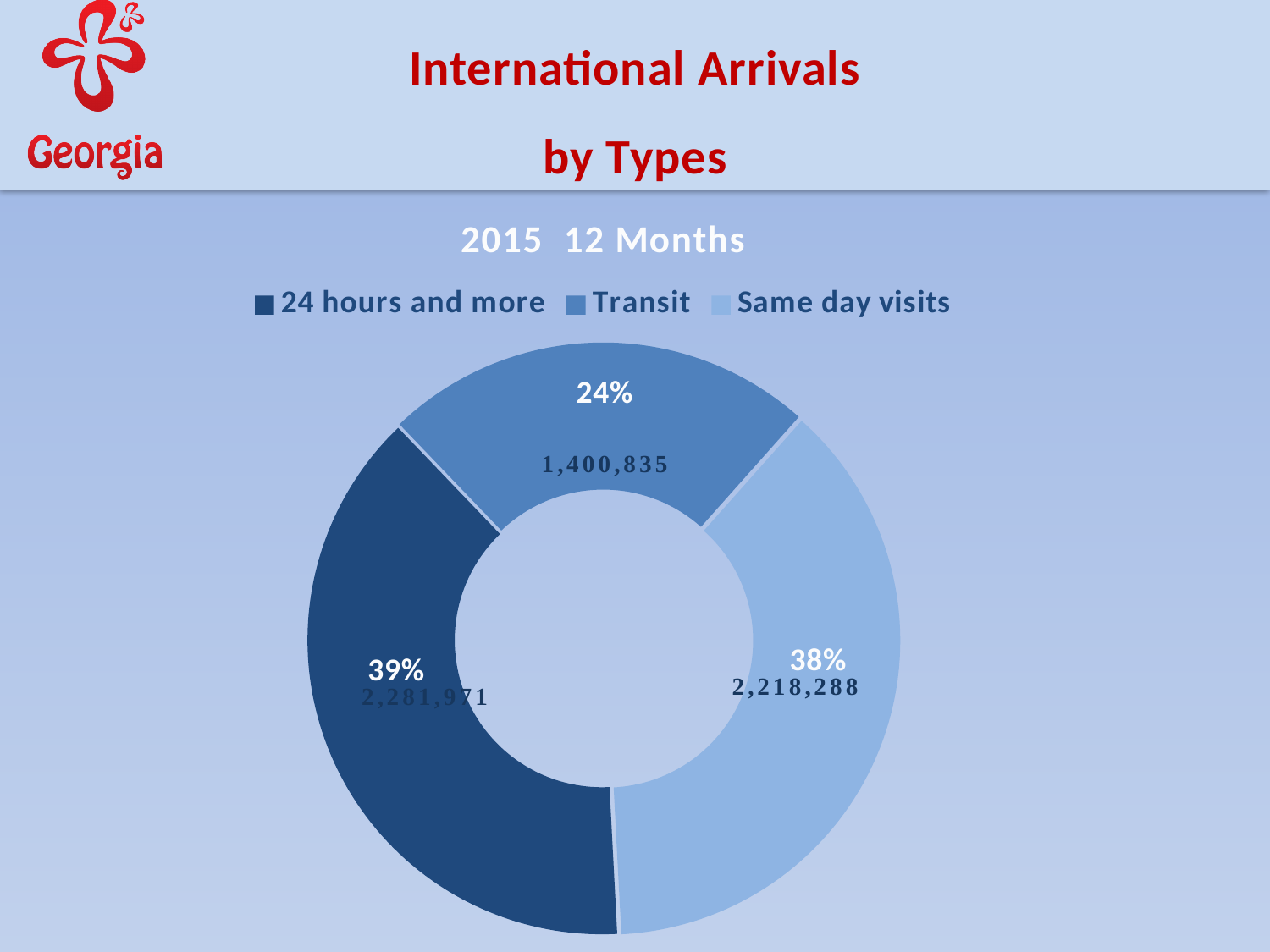
What is the number of arrivals for 24 hours and more? 2,281,971 What share of international arrivals is 24 hours and more? 39% What kind of chart is shown on the slide? doughnut chart What share of international arrivals is Same day visits? 38% What is the number of arrivals for Same day visits? 2,218,288 What is the number of arrivals for Transit? 1,400,835 Which arrival type has the largest share? 24 hours and more Which arrival type has the smallest share? Transit What is the difference in arrivals between 24 hours and more and Transit? 881,136 Which has more arrivals, Same day visits or Transit? Same day visits How many arrival types are shown in the chart? 3 What share of international arrivals is Transit? 24%